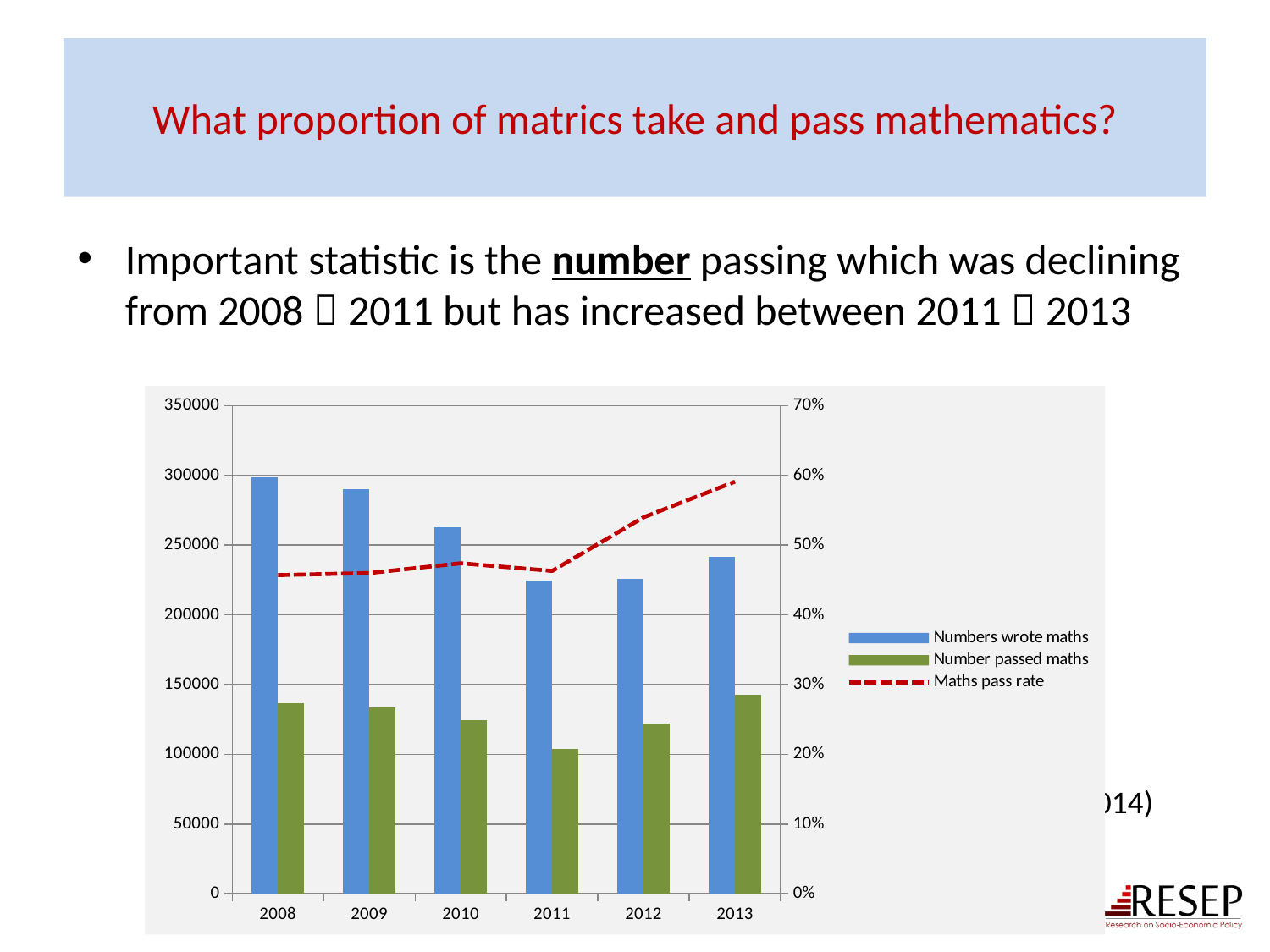
What kind of chart is shown on the slide? A bar chart with a dashed line for the pass rate Which year has the highest value for Numbers wrote maths? 2008 Which is larger: Numbers wrote maths in 2010 or in 2013? 2010 Is the Maths pass rate in 2008 greater or less than 50%? less Is the value for Numbers wrote maths in 2011 greater or less than 250000? less How many years are shown on the x axis of the chart? 6 Is the Maths pass rate in 2013 greater or less than 50%? greater Which year has the lowest value for Number passed maths? 2011 Does the Maths pass rate rise or fall between 2011 and 2013? rise Which year has the highest Maths pass rate? 2013 How many series does the chart's legend list? 3